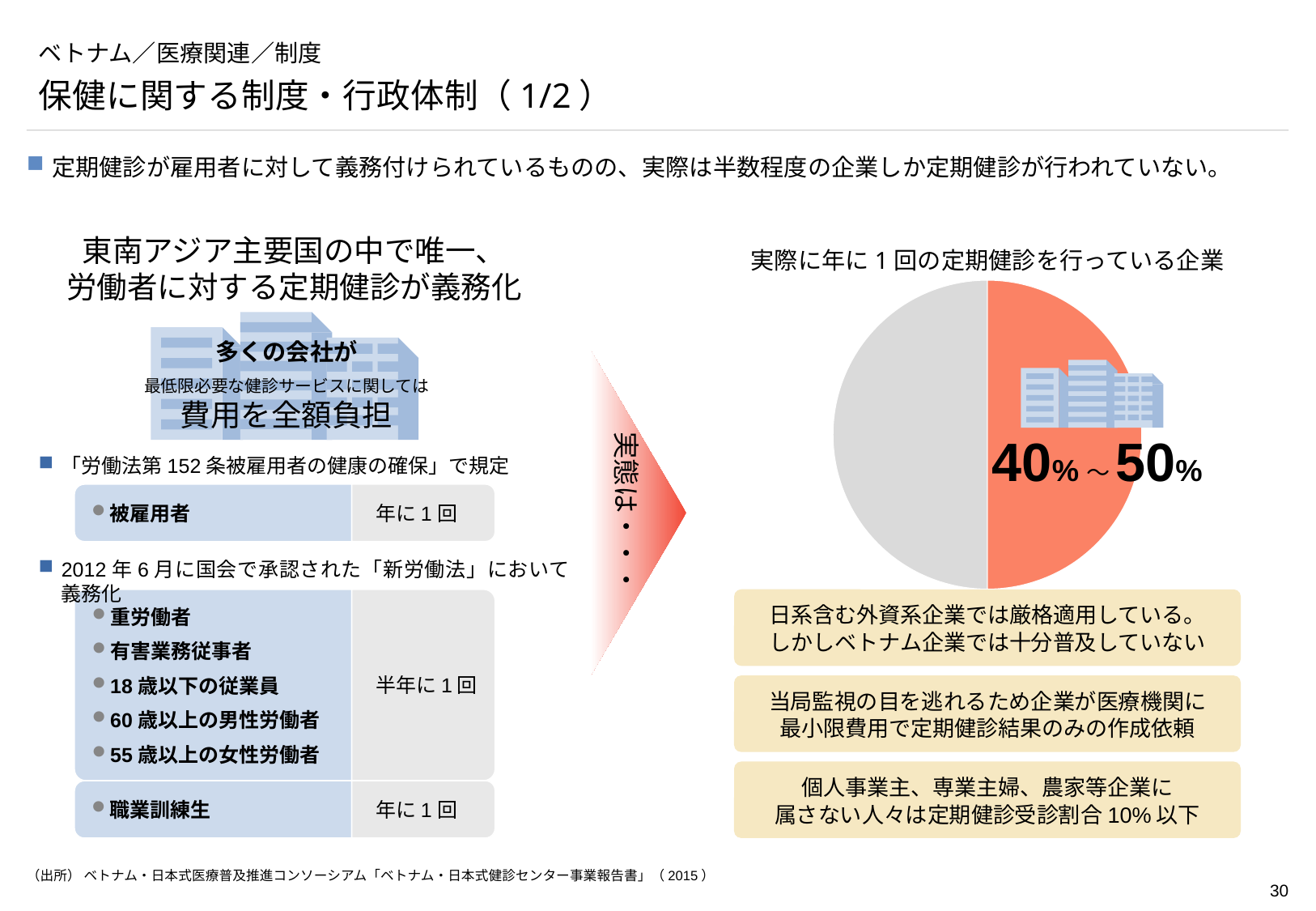
What colour is the slice of the pie chart that carries the printed value label? red What is the title of the pie chart? 実際に年に1回の定期健診を行っている企業 What kind of chart is shown on the right side of the slide? pie chart How many slices does the pie chart have? 2 Is the share of companies conducting annual health check-ups shown in the pie chart greater or less than 30%? greater According to the pie chart, what share of companies actually conduct an annual health check-up? 40%～50% What value is printed on the red slice of the pie chart? 40%～50% Is the share of companies conducting annual health check-ups shown in the pie chart greater or less than 60%? less